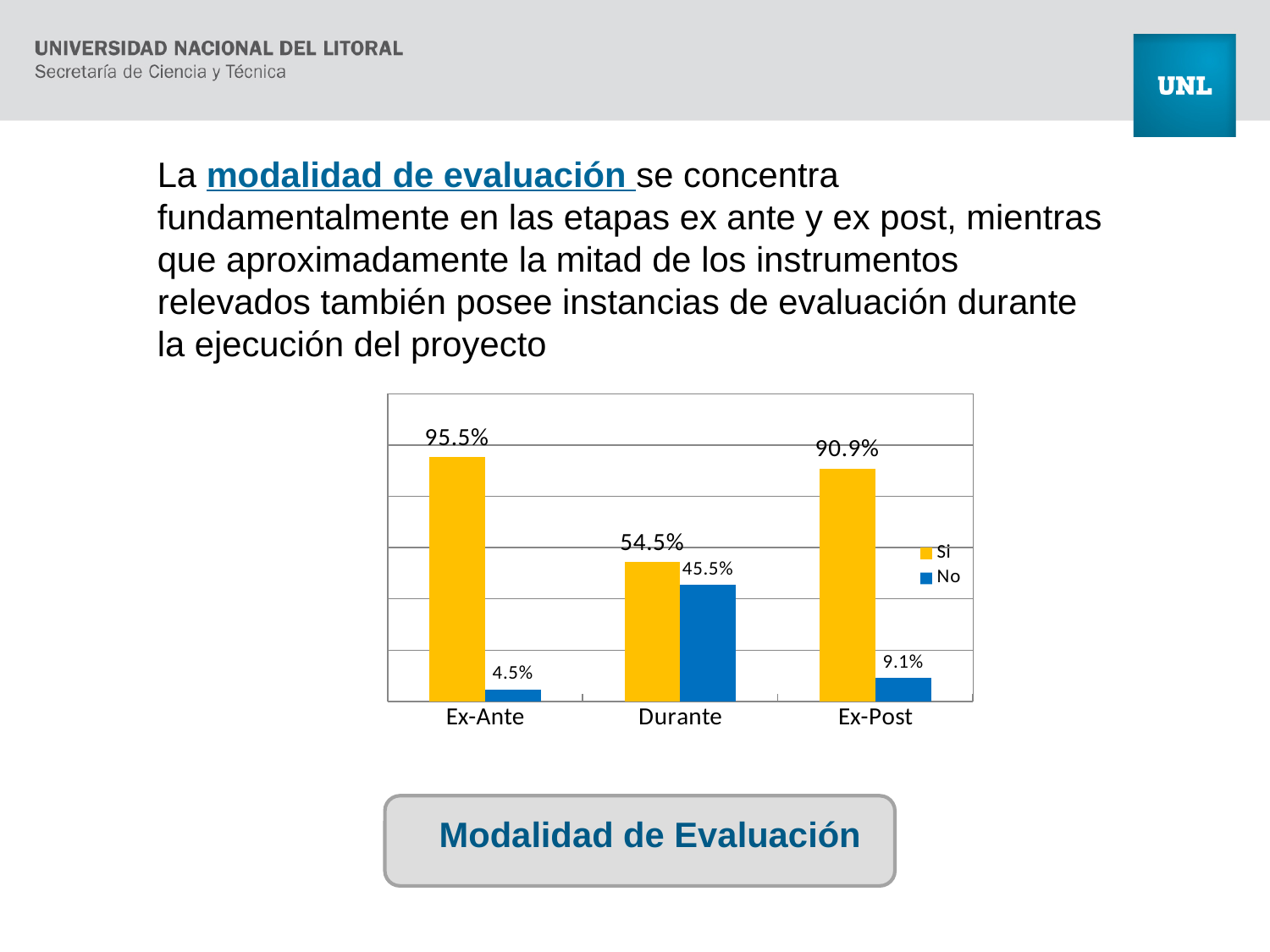
What is the value for No in the Ex-Ante category? 4.5% Which category has the lowest value for No? Ex-Ante What is the value for Si in the Ex-Ante category? 95.5% How many series does the legend list? 2 Which is larger, the No value for Ex-Post or the No value for Ex-Ante? Ex-Post Which colour represents the Si series? Yellow What is the difference between the Si and No values in the Durante category? 9.0% How many categories are shown on the x axis? 3 What is the value for Si in the Ex-Post category? 90.9% What kind of chart is shown on the slide? Bar chart Which category has the highest value for Si? Ex-Ante What is the value for No in the Durante category? 45.5%